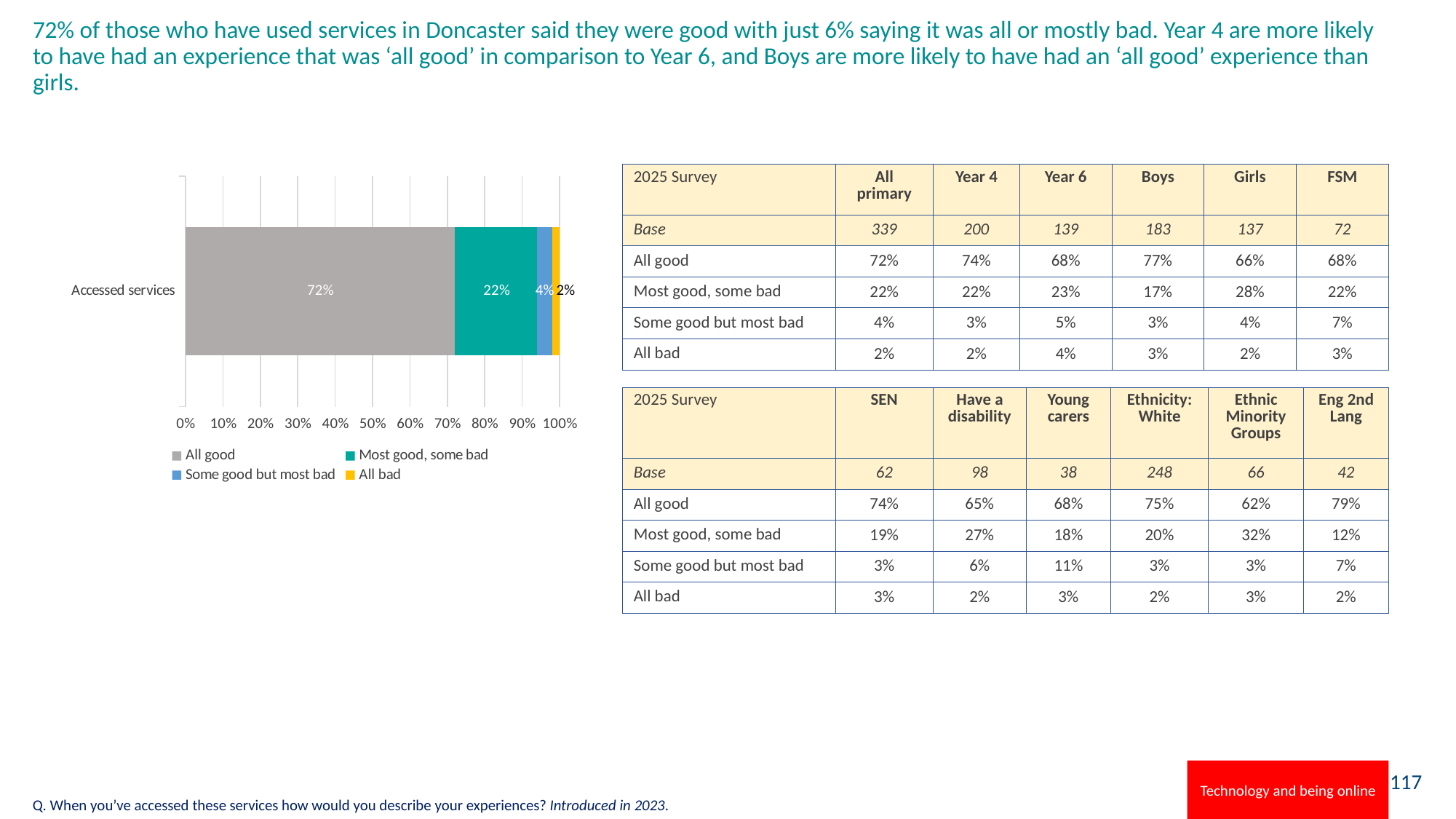
What type of chart is shown on the slide? Stacked bar chart Which is larger in the chart, 'Some good but most bad' or 'All bad'? Some good but most bad How many series does the chart legend list? 4 What value is shown for 'Most good, some bad' in the chart? 22% Which series has the largest segment in the 'Accessed services' bar? All good Which series has the smallest segment in the 'Accessed services' bar? All bad How many categories (bars) are plotted in the chart? 1 What is the total of all segments in the 'Accessed services' stacked bar? 100% What percentage of the 'Accessed services' bar is 'All good'? 72% What value is shown for 'All bad' in the chart? 2% What value is shown for 'Some good but most bad' in the chart? 4% What is the difference between the 'All good' and 'Most good, some bad' segments in the chart? 50 percentage points